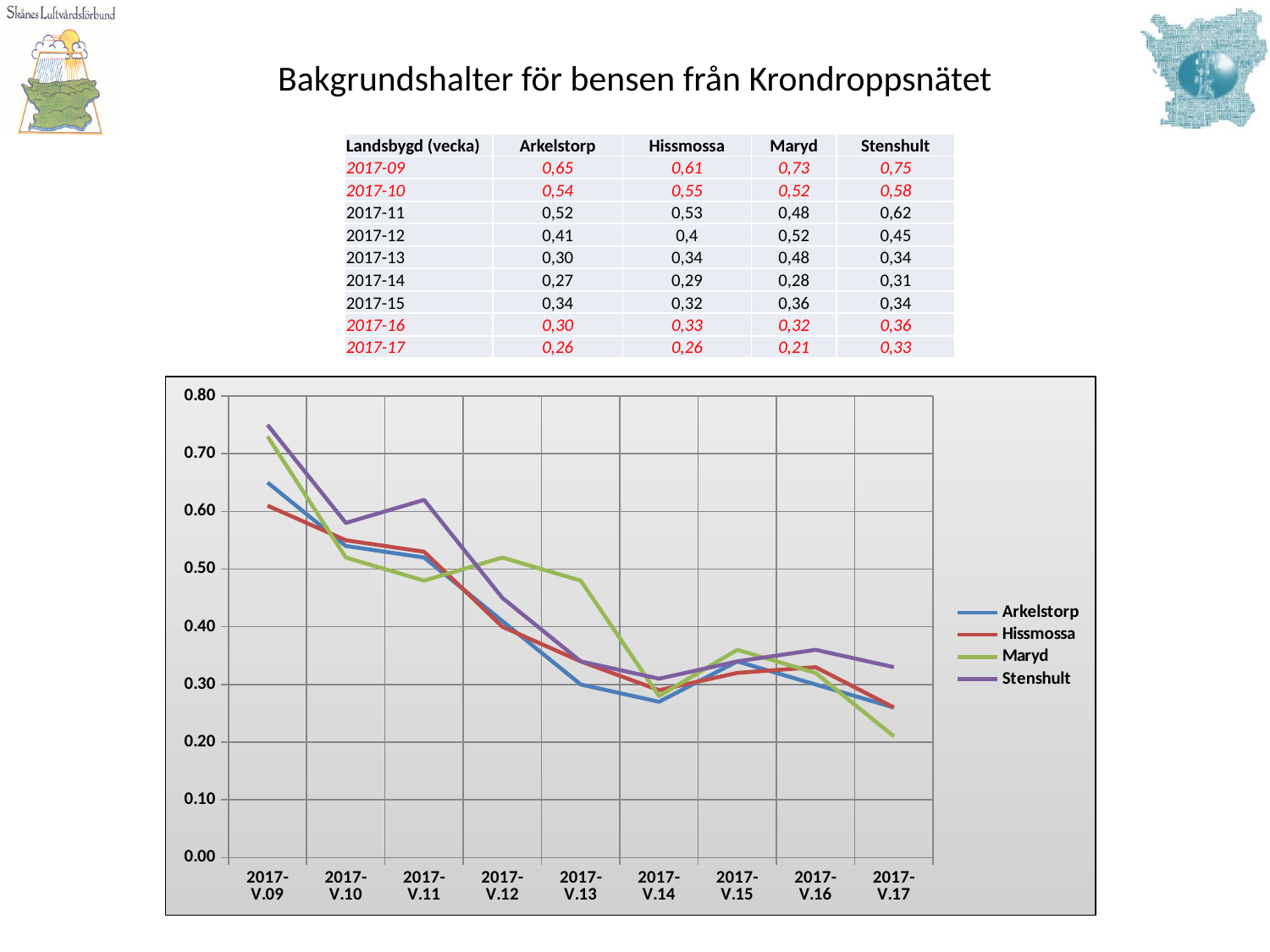
Which station has the lowest value in week 2017-17? Maryd What is the value for Stenshult in week 2017-09? 0,75 How many series does the chart legend list? 4 Do the values for Arkelstorp generally rise or fall from 2017-V.09 to 2017-V.17? fall Is the value for Stenshult at 2017-V.12 greater or less than 0.40? greater What is the difference between the Arkelstorp values in week 2017-09 and week 2017-17? 0,39 In week 2017-13, which is larger: the value for Maryd or the value for Arkelstorp? Maryd Which series is drawn in purple in the chart? Stenshult What kind of chart is shown on the slide? line chart Which station has the highest value in week 2017-09? Stenshult What is the value for Maryd in week 2017-17? 0,21 How many weeks are plotted along the x axis of the chart? 9